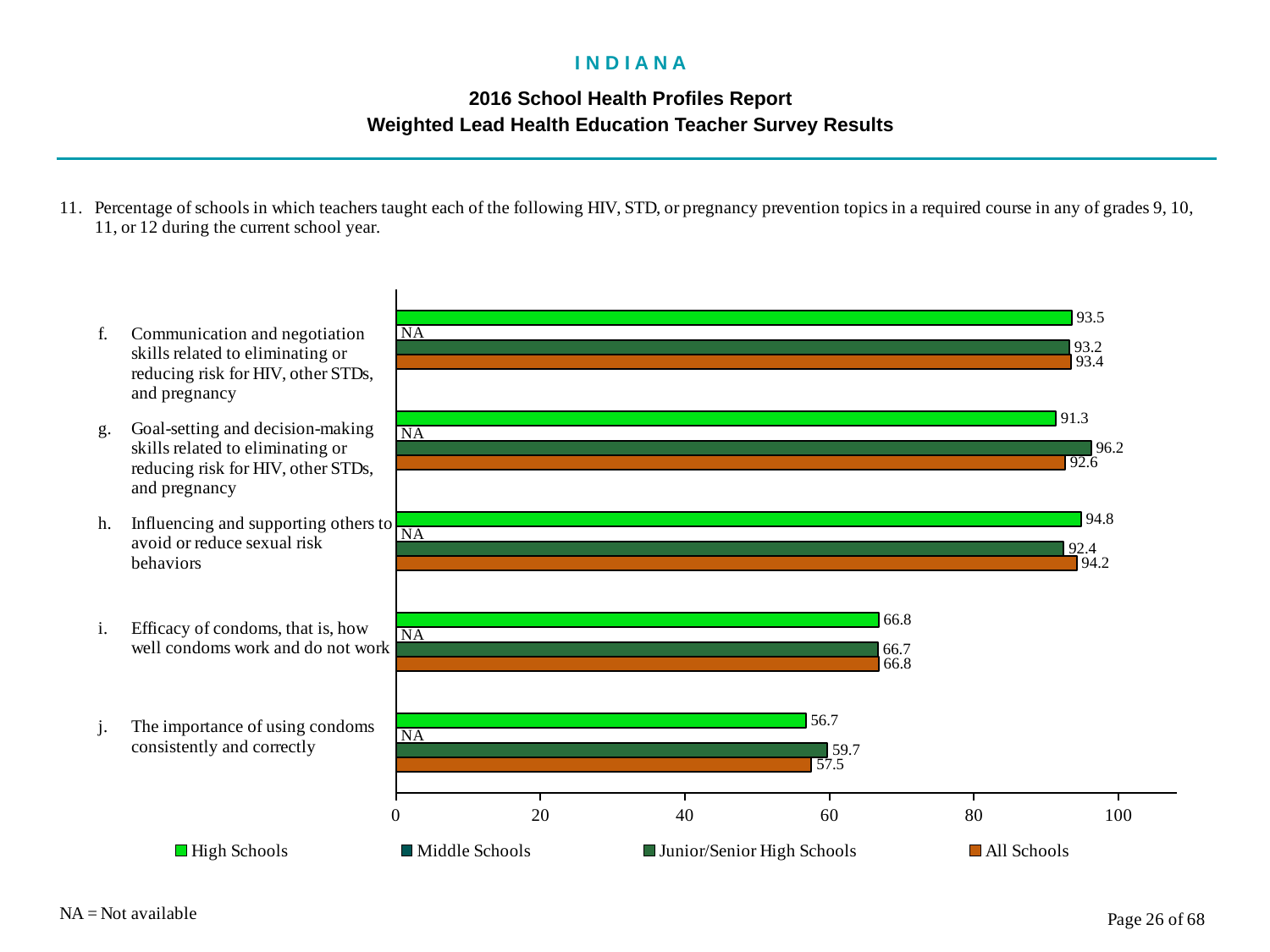
What is shown for Middle Schools for topic i, efficacy of condoms? NA Which topic has the lowest All Schools value? j. The importance of using condoms consistently and correctly What is the All Schools value for topic h, influencing and supporting others to avoid or reduce sexual risk behaviors? 94.2 For topic g, which is larger: the High Schools value or the Junior/Senior High Schools value? Junior/Senior High Schools What is the difference between the Junior/Senior High Schools and High Schools values for topic j? 3.0 What is the Junior/Senior High Schools value for topic g, goal-setting and decision-making skills? 96.2 How many series does the legend list? 4 What kind of chart is shown on the slide? bar chart How many topics are listed on the chart? 5 Is the All Schools value for topic i greater or less than 80? less What is the High Schools value for topic j, the importance of using condoms consistently and correctly? 56.7 Which topic has the highest High Schools value? h. Influencing and supporting others to avoid or reduce sexual risk behaviors